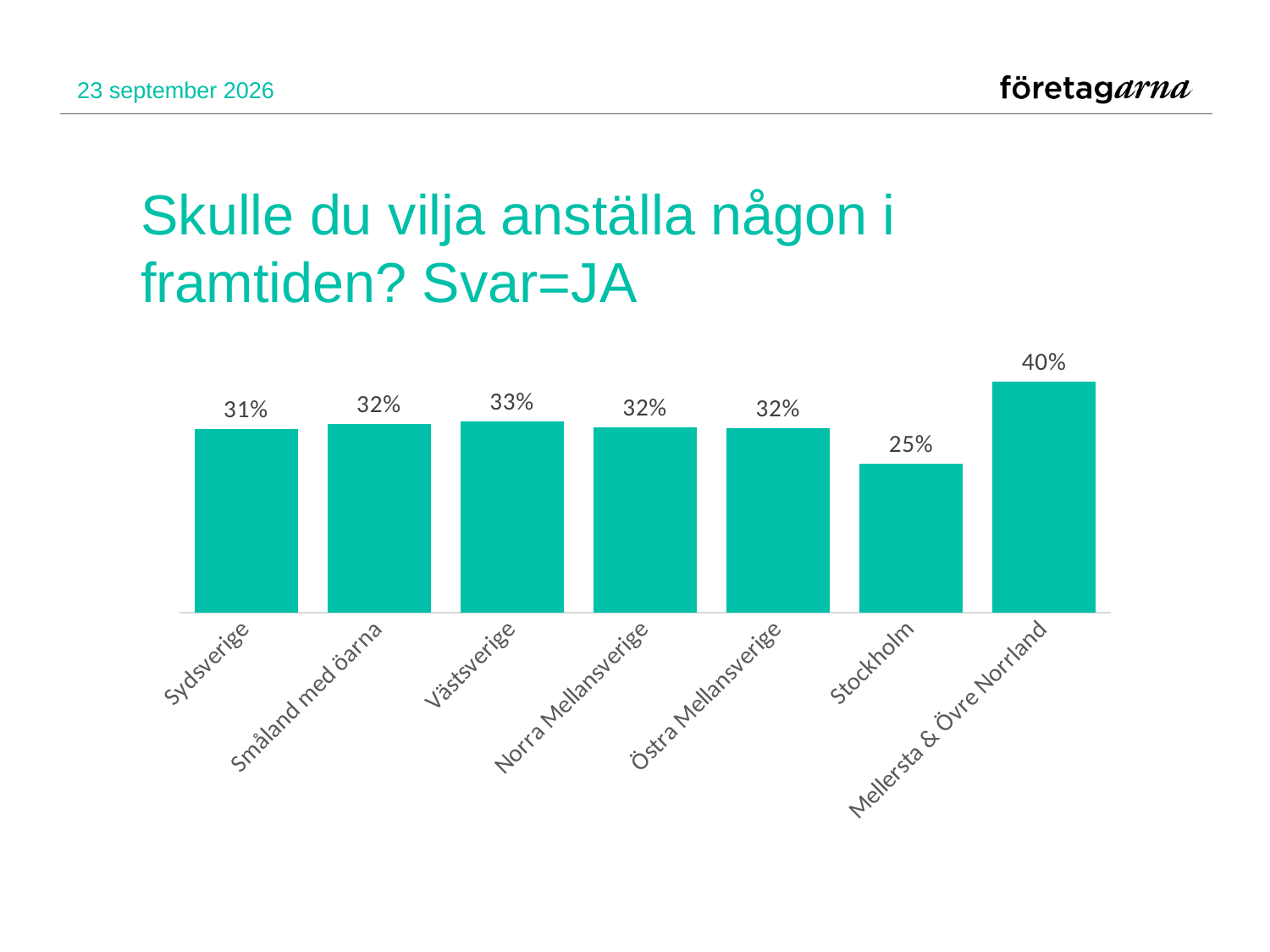
What is the value for Mellersta & Övre Norrland? 40% Which region has the highest value? Mellersta & Övre Norrland What is the difference between the values for Mellersta & Övre Norrland and Stockholm? 15% What is the difference between the values for Västsverige and Sydsverige? 2% Which is larger, the value for Stockholm or the value for Norra Mellansverige? Norra Mellansverige What is the value for Stockholm? 25% What kind of chart is shown on the slide? Bar chart What is the value for Västsverige? 33% What is the value for Sydsverige? 31% Which region has the lowest value? Stockholm What is the title of the slide? Skulle du vilja anställa någon i framtiden? Svar=JA How many regions are shown in the chart? 7